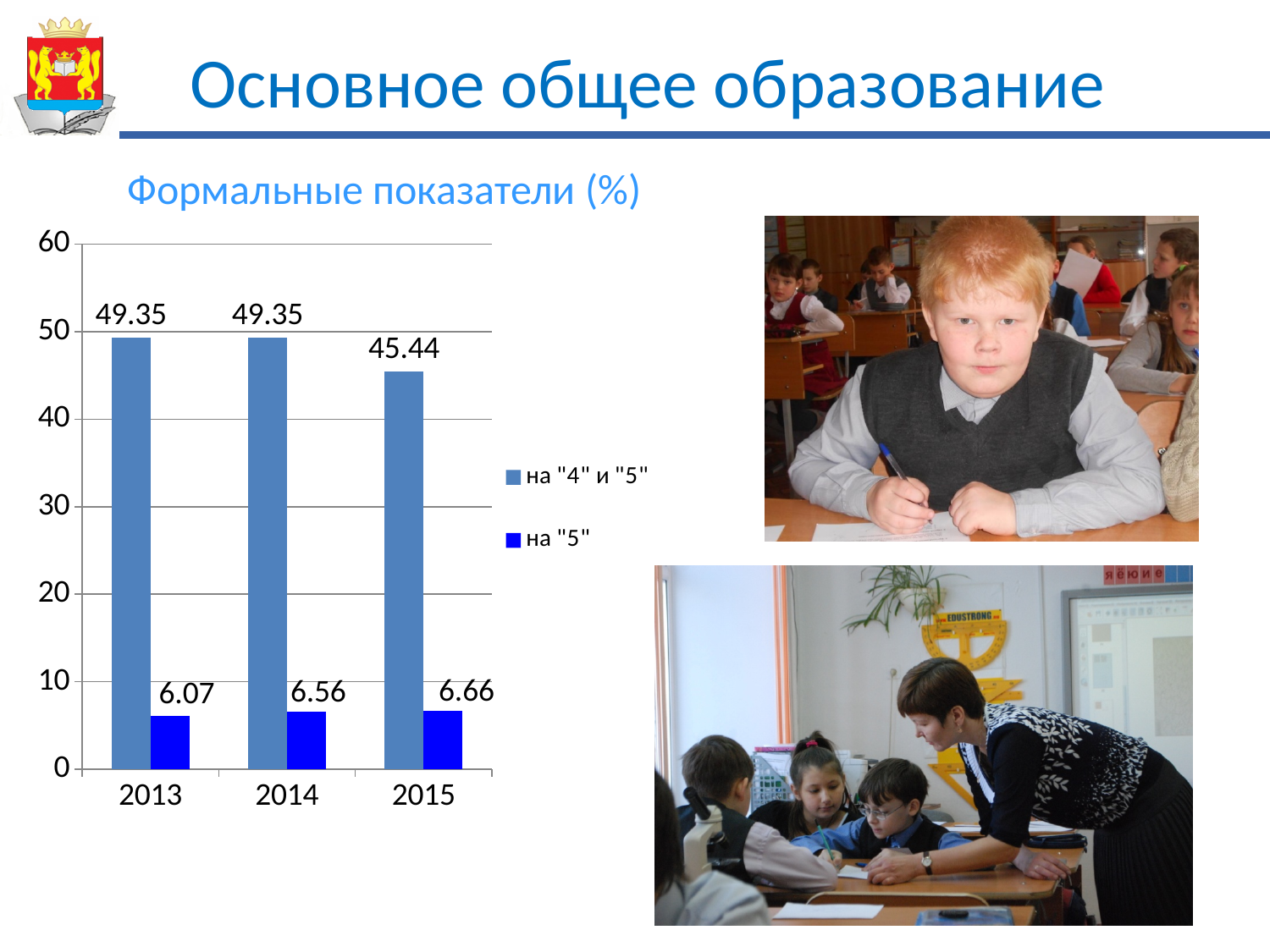
What is the value for на "5" in 2013? 6.07 What is the difference between the на "5" values for 2015 and 2013? 0.59 What kind of chart is shown on the slide? bar chart What is the value for на "5" in 2014? 6.56 How many series does the legend list? 2 Which is larger: the на "5" value for 2014 or for 2013? 2014 Is the value for на "4" и "5" in 2013 greater or less than 40? greater What is the value for на "4" и "5" in 2015? 45.44 How many years are shown on the x axis? 3 In which year is the value for на "4" и "5" the lowest? 2015 In which year is the value for на "5" the highest? 2015 What is the difference between the на "4" и "5" values for 2014 and 2015? 3.91